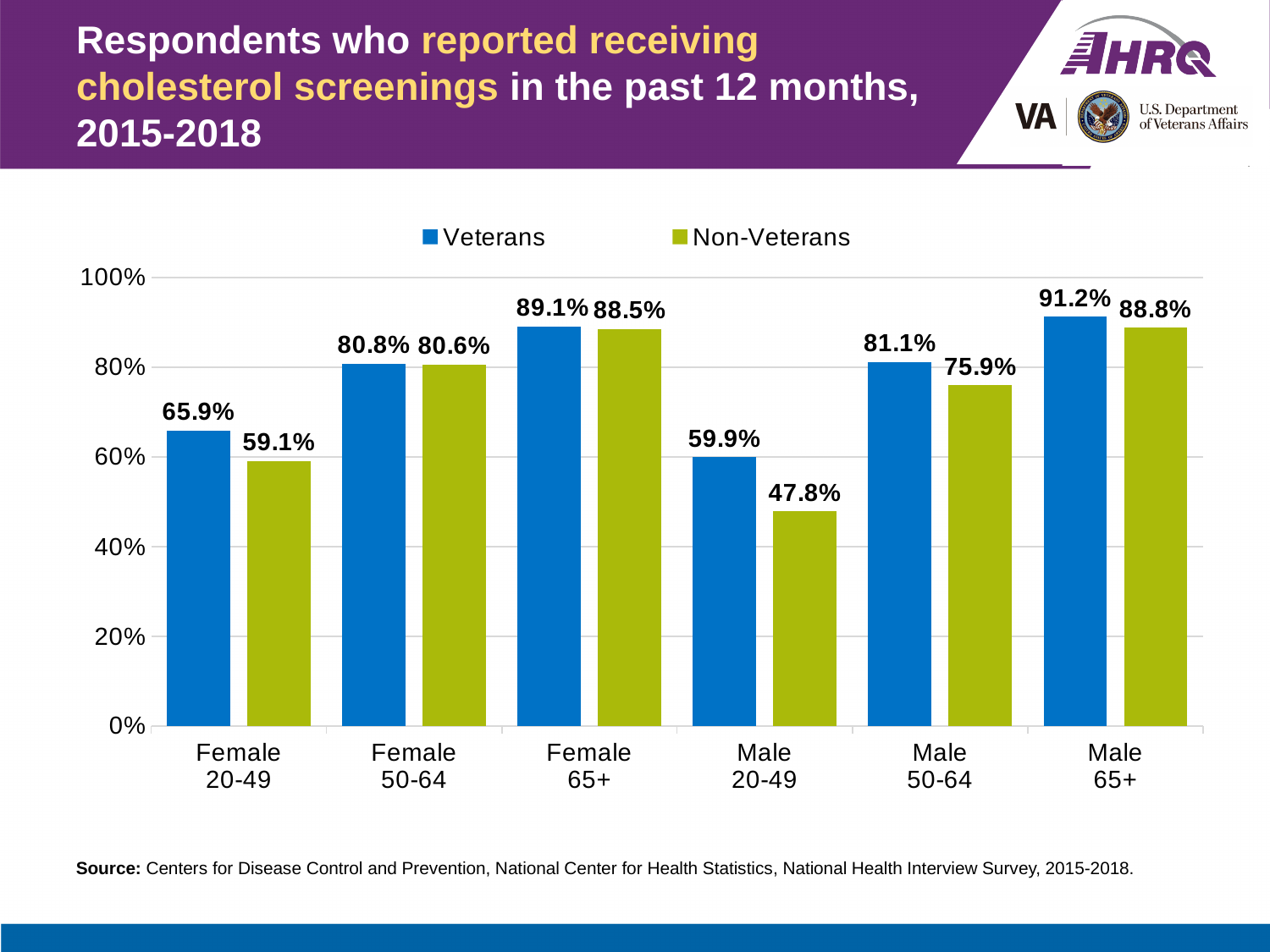
What is the difference between Veterans and Non-Veterans in the Male 20-49 group? 12.1% Which group has the highest value for Veterans? Male 65+ Which is larger in the Male 50-64 group, Veterans or Non-Veterans? Veterans What percentage of Veterans aged Female 20-49 reported receiving cholesterol screenings? 65.9% What is the difference between Veterans and Non-Veterans in the Female 20-49 group? 6.8% How many age-sex groups are shown on the x axis? 6 Which group has the lowest value for Non-Veterans? Male 20-49 How many series does the legend list? 2 Which colour represents Non-Veterans in the chart? Green What kind of chart is shown on the slide? Bar chart What is the value for Non-Veterans in the Male 20-49 group? 47.8% What is the value for Veterans in the Male 50-64 group? 81.1%